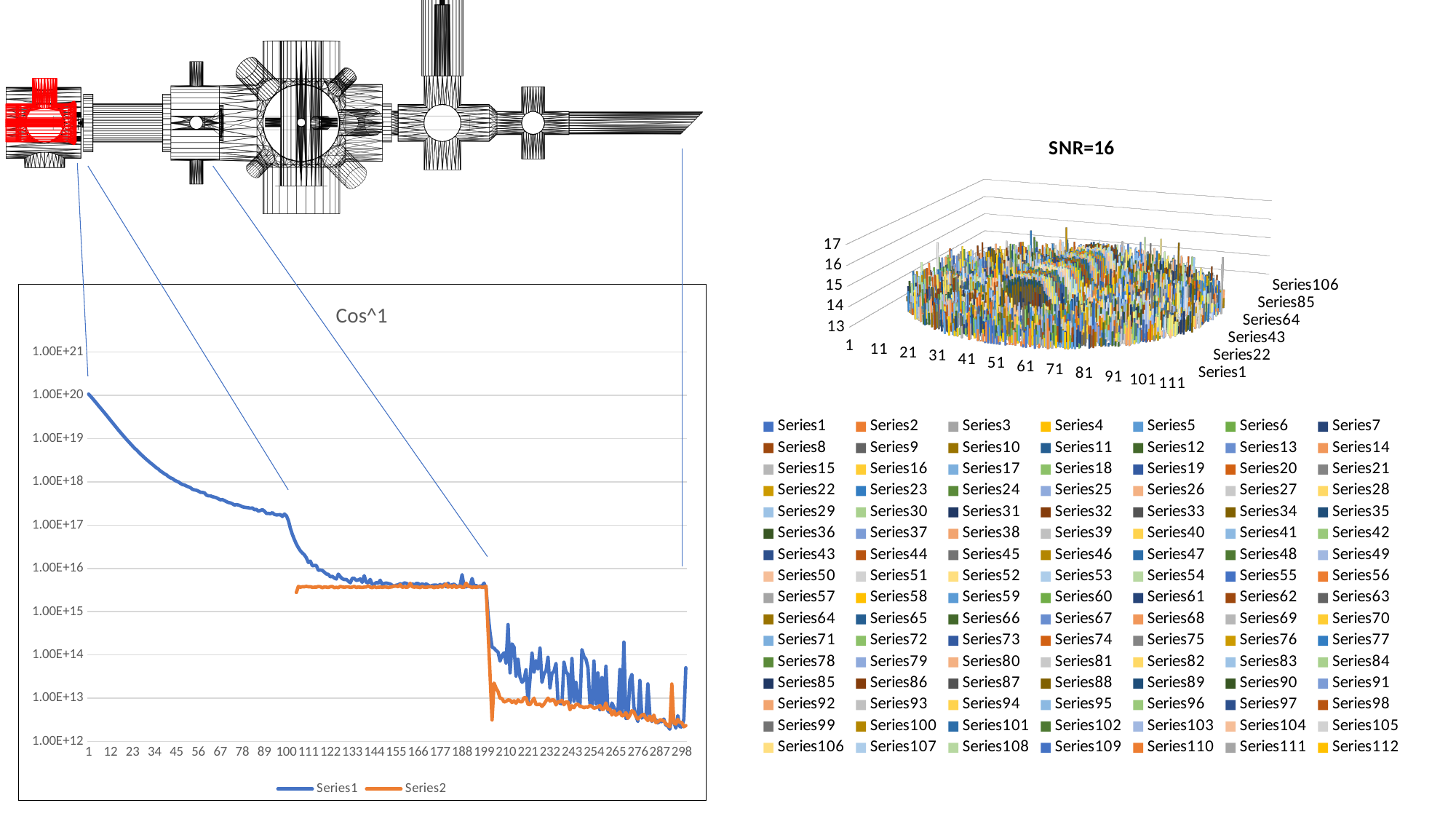
What is the highest tick label on the y axis of the Cos^1 chart? 1.00E+21 In the Cos^1 chart, which series is drawn in orange? Series2 In the Cos^1 chart, do the values of Series1 rise or fall overall along the x axis? fall What kind of chart is the Cos^1 chart? line chart In the Cos^1 chart, is the value of Series2 at x = 298 greater or less than 1.00E+14? less What is the title of the chart on the right of the slide? SNR=16 What is the title of the chart on the left of the slide? Cos^1 What kind of chart is the SNR=16 chart? 3D bar chart How many series does the legend of the Cos^1 chart list? 2 In the Cos^1 chart, is the value of Series1 at x = 1 greater or less than 1.00E+19? greater How many series does the legend of the SNR=16 chart list? 112